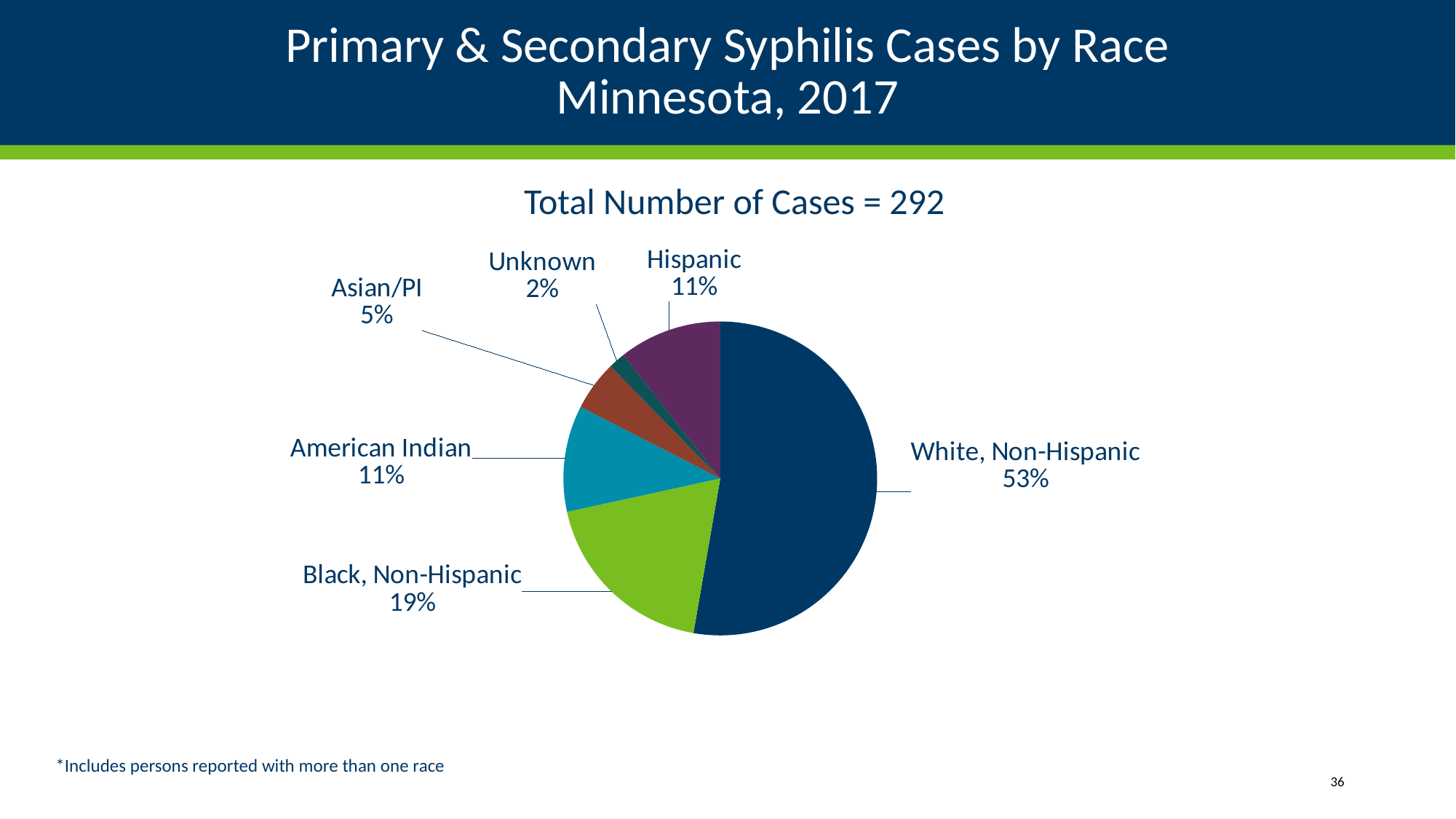
What share of cases is Asian/PI? 5% What share of cases is White, Non-Hispanic? 53% What kind of chart is shown on the slide? pie chart Which is larger, the share for Black, Non-Hispanic or the share for Hispanic? Black, Non-Hispanic How many race categories are shown in the pie chart? 6 What share of cases is American Indian? 11% What is the difference in percentage points between the White, Non-Hispanic and Black, Non-Hispanic shares? 34 Which race category has the smallest share of cases? Unknown Which race category has the largest share of cases? White, Non-Hispanic What is the total number of cases stated above the chart? 292